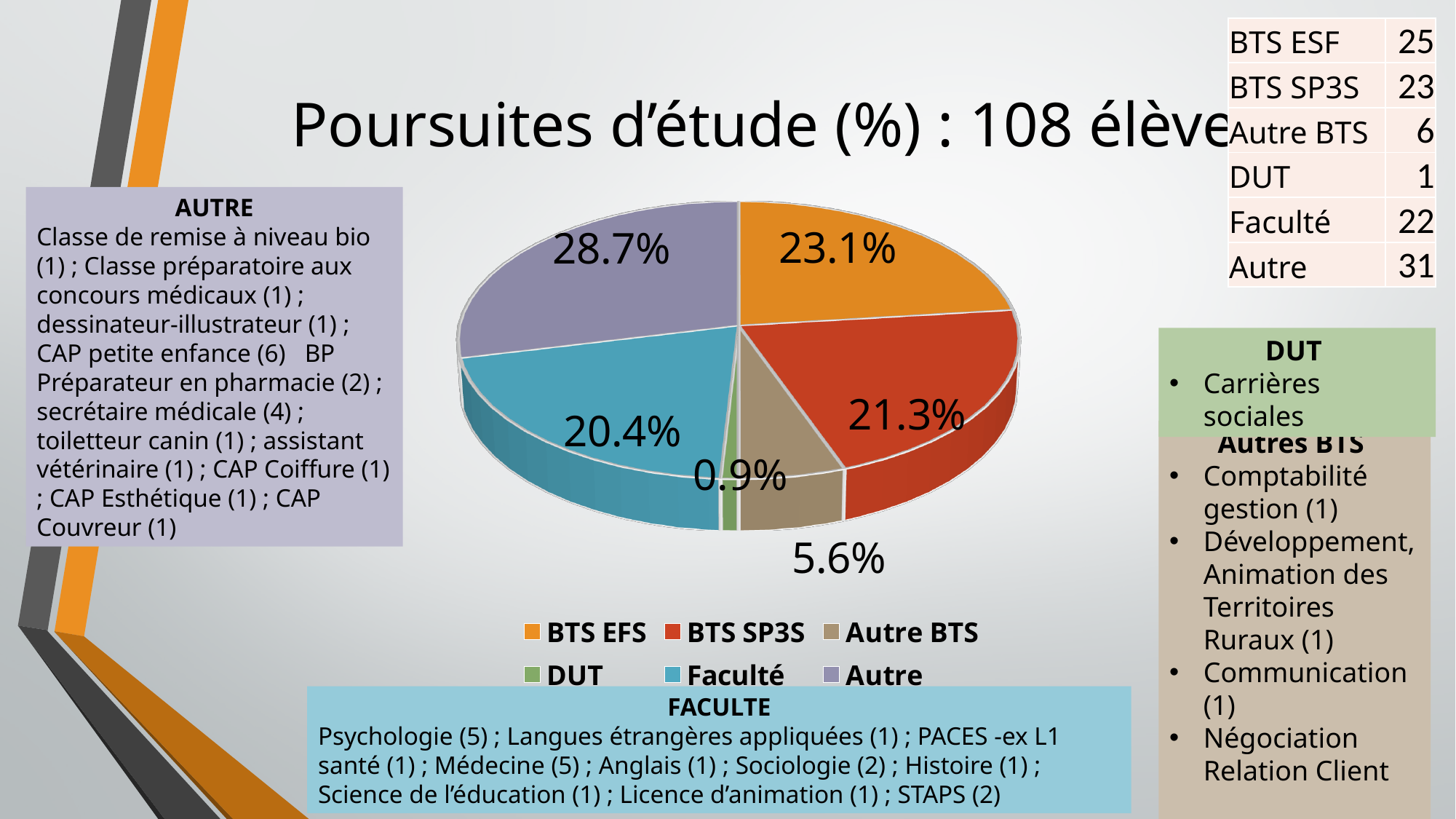
What type of chart is shown on the slide? Pie chart Which category has the smallest slice of the pie chart? DUT What percentage of the pie chart is the BTS SP3S slice? 21.3% What percentage of the pie chart is the Faculté slice? 20.4% How many slices does the pie chart have? 6 What percentage of the pie chart is the Autre BTS slice? 5.6% Which slice is larger, BTS EFS or BTS SP3S? BTS EFS What percentage of the pie chart is the BTS EFS slice? 23.1% What is the difference in percentage points between the Autre slice and the Faculté slice? 8.3 How many entries does the chart legend list? 6 What colour is the Faculté slice in the pie chart? Teal (blue) Which category has the largest slice of the pie chart? Autre